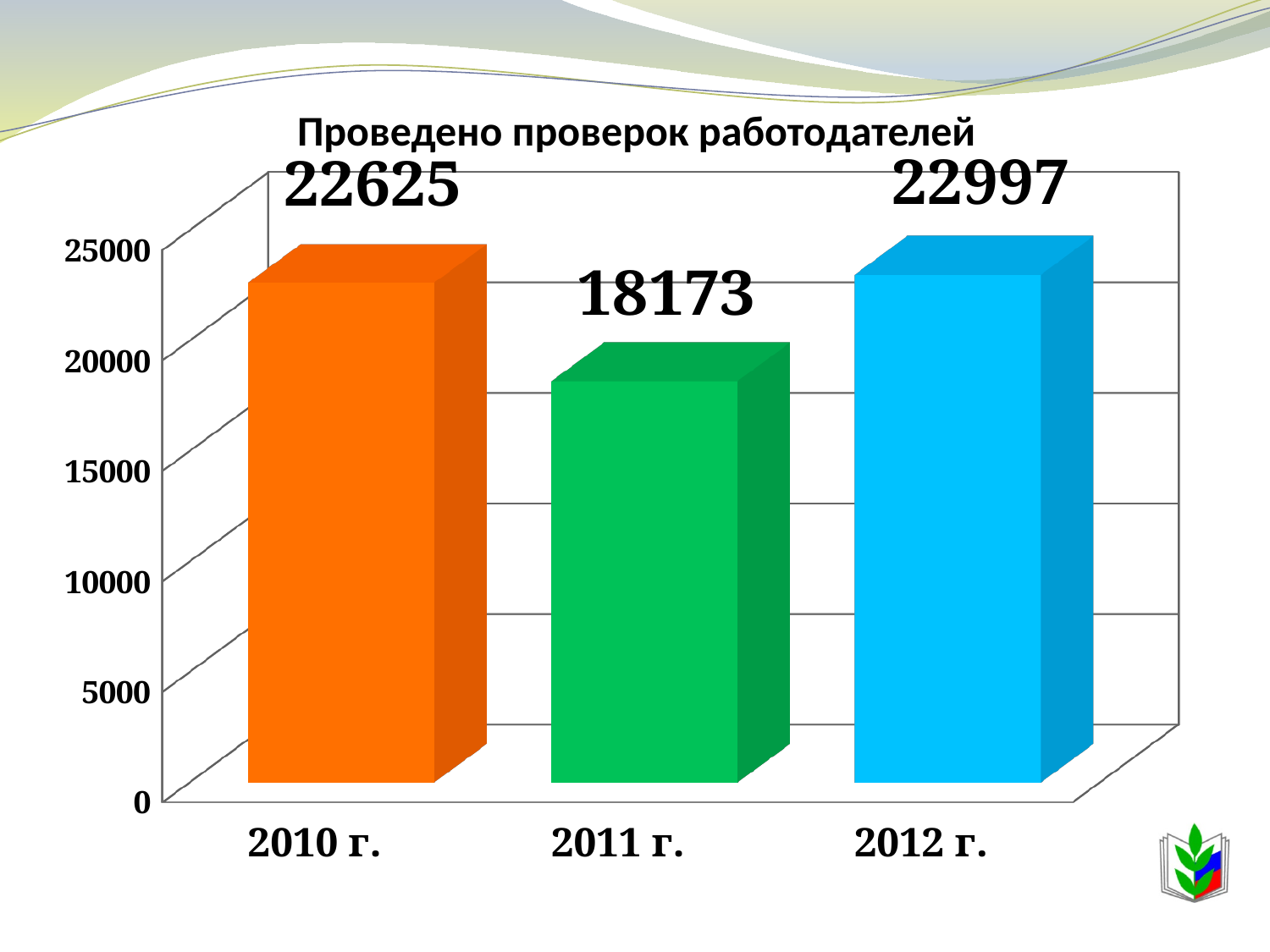
Which year has the lowest value? 2011 г. What kind of chart is shown on the slide? bar chart What is the title of the chart? Проведено проверок работодателей Is the value for 2011 г. greater or less than 20000? less Which is larger, the value for 2010 г. or the value for 2011 г.? 2010 г. What is the difference between the values for 2010 г. and 2011 г.? 4452 What is the value for 2010 г.? 22625 What is the difference between the values for 2012 г. and 2011 г.? 4824 How many years are shown on the chart? 3 What is the value for 2012 г.? 22997 Which year has the highest value? 2012 г. What is the value for 2011 г.? 18173